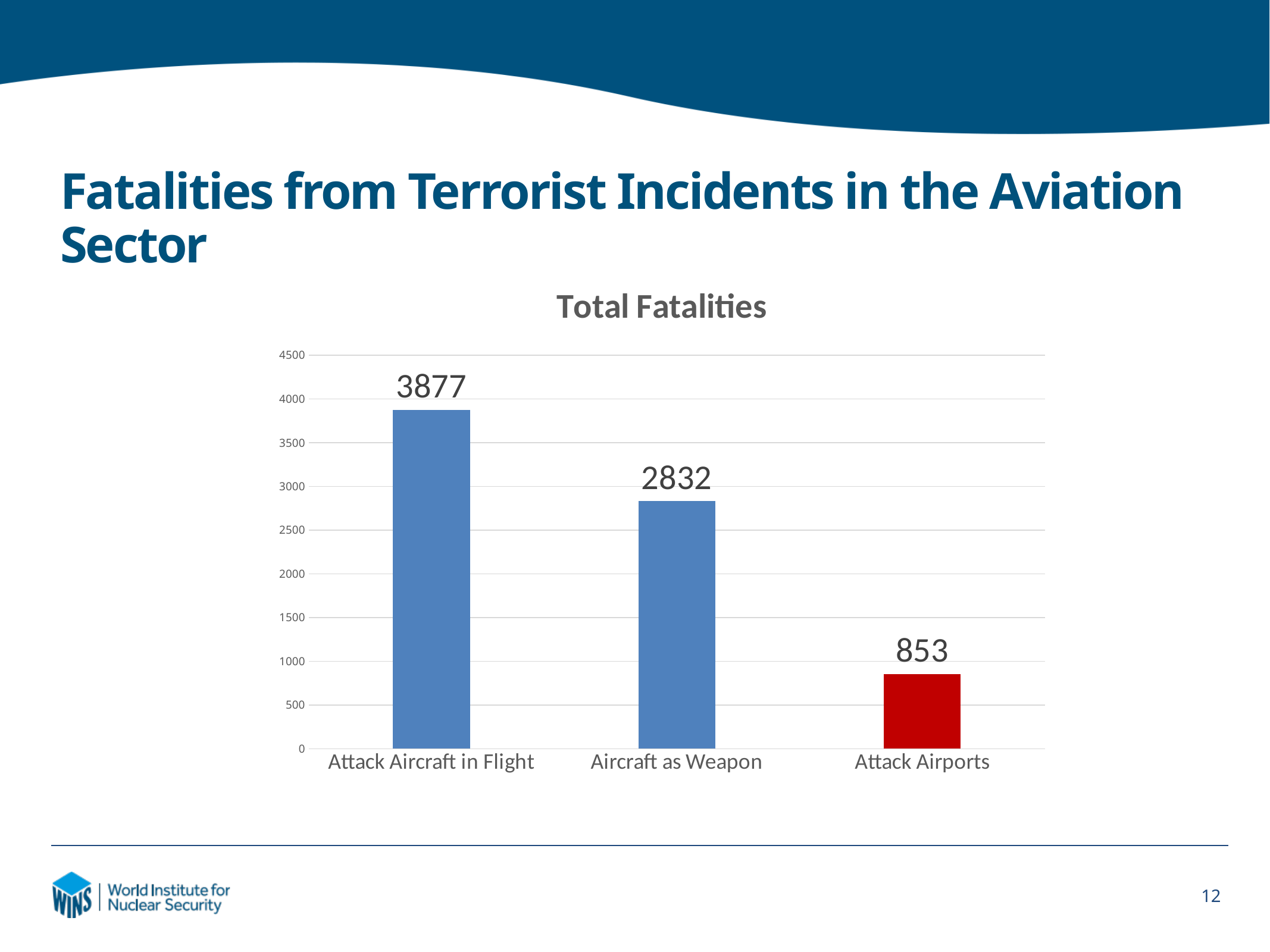
Is the value for Attack Airports greater or less than 1000? less Which is larger, the value for Aircraft as Weapon or the value for Attack Airports? Aircraft as Weapon What kind of chart is shown on the slide? bar chart Which category has the lowest total fatalities? Attack Airports What is the value for Attack Aircraft in Flight? 3877 What is the title of the chart? Total Fatalities How many categories are shown in the chart? 3 What is the difference between the values for Attack Aircraft in Flight and Aircraft as Weapon? 1045 What is the value for Attack Airports? 853 What is the value for Aircraft as Weapon? 2832 Which category has the highest total fatalities? Attack Aircraft in Flight What is the difference between the values for Aircraft as Weapon and Attack Airports? 1979